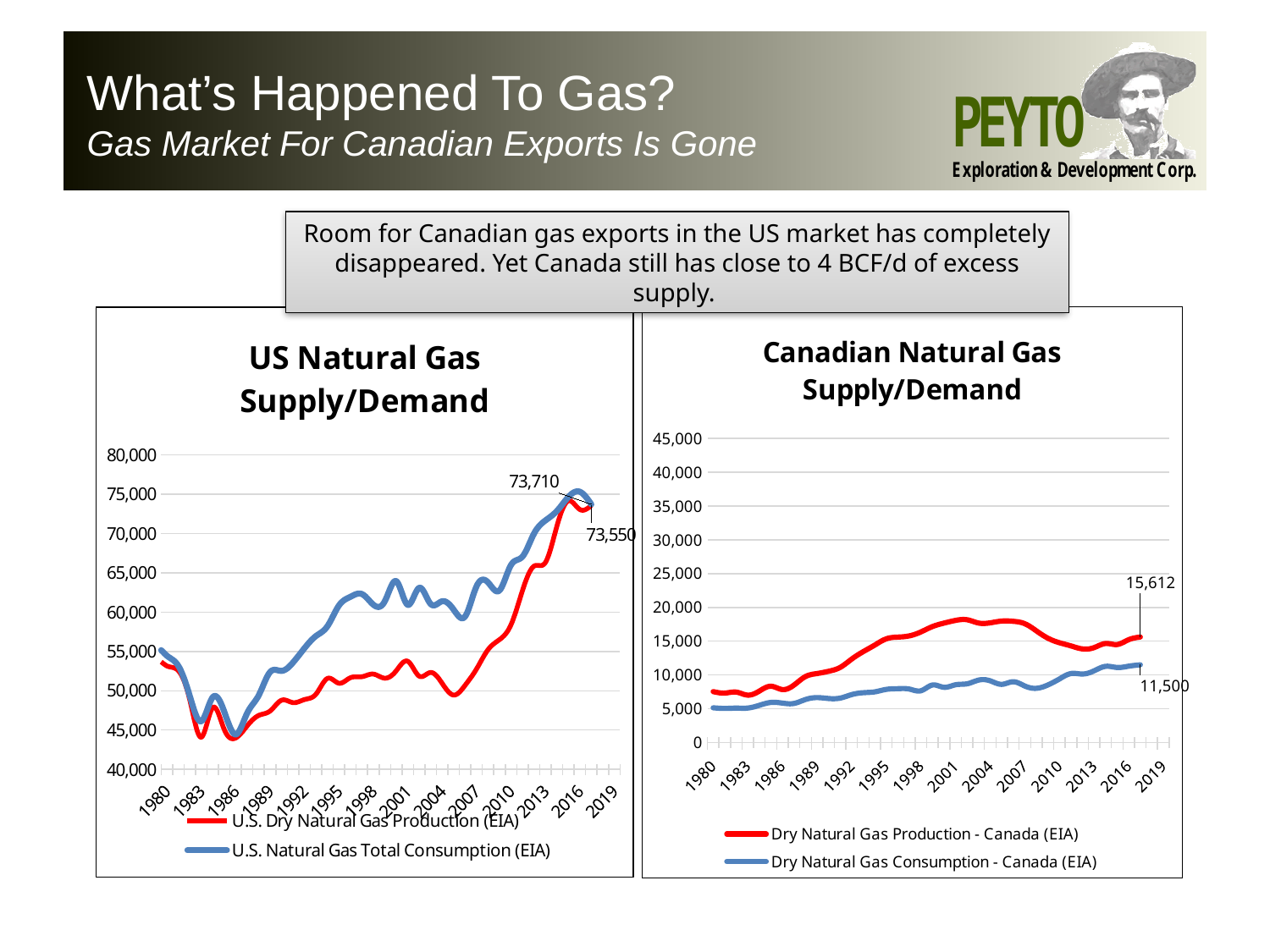
In the Canadian Natural Gas Supply/Demand chart, which colour is used for the Dry Natural Gas Production - Canada (EIA) line? Red What kind of chart is the Canadian Natural Gas Supply/Demand chart? Line chart In the US Natural Gas Supply/Demand chart, what is the labelled final value of U.S. Dry Natural Gas Production (EIA)? 73,550 How many series does the legend of the US Natural Gas Supply/Demand chart list? 2 In the US Natural Gas Supply/Demand chart, is the value of U.S. Natural Gas Total Consumption (EIA) in 1980 greater or less than 60,000? less In the Canadian Natural Gas Supply/Demand chart, what is the labelled final value of Dry Natural Gas Consumption - Canada (EIA)? 11,500 In the US Natural Gas Supply/Demand chart, what is the labelled final value of U.S. Natural Gas Total Consumption (EIA)? 73,710 In the Canadian Natural Gas Supply/Demand chart, what is the labelled final value of Dry Natural Gas Production - Canada (EIA)? 15,612 In the Canadian Natural Gas Supply/Demand chart, does Dry Natural Gas Consumption - Canada (EIA) generally rise or fall from 1980 to 2019? Rise In the Canadian Natural Gas Supply/Demand chart, what is the difference between the labelled final production value and the labelled final consumption value? 4,112 In the Canadian Natural Gas Supply/Demand chart, is the value of Dry Natural Gas Production - Canada (EIA) in 1980 greater or less than 10,000? less